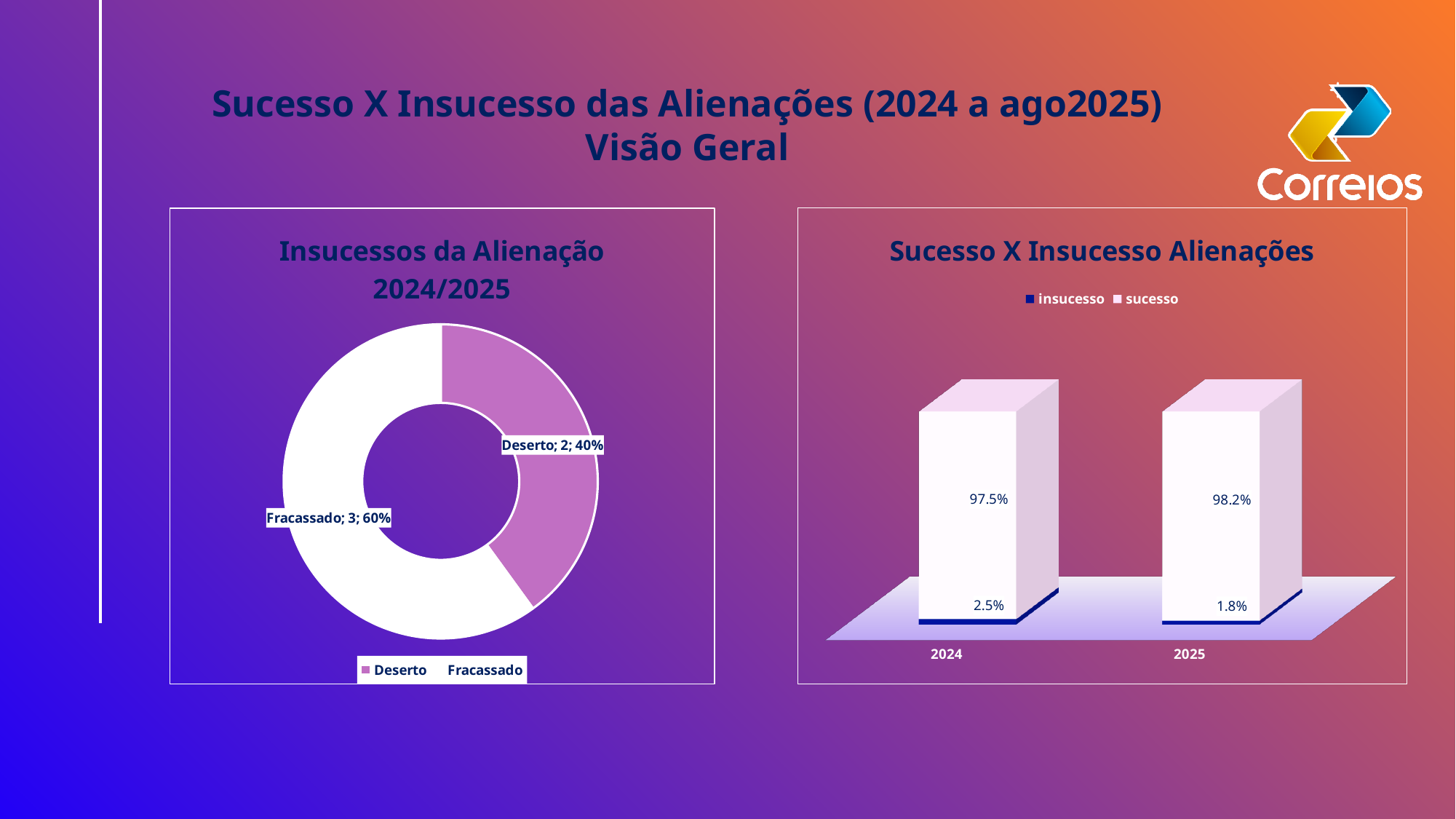
In the 'Sucesso X Insucesso Alienações' chart, does the insucesso value rise or fall from 2024 to 2025? Fall In the 'Sucesso X Insucesso Alienações' chart, what is the insucesso value for 2025? 1.8% In the 'Sucesso X Insucesso Alienações' chart, which year has the higher sucesso value? 2025 In the 'Insucessos da Alienação 2024/2025' chart, what is the difference between the Fracassado and Deserto counts? 1 In the 'Sucesso X Insucesso Alienações' chart, what is the sucesso value for 2024? 97.5% What kind of chart is 'Insucessos da Alienação 2024/2025'? Doughnut chart How many categories does the 'Insucessos da Alienação 2024/2025' chart show? 2 In the 'Insucessos da Alienação 2024/2025' chart, what share of the total does Fracassado represent? 60% In the 'Sucesso X Insucesso Alienações' chart, how many series does the legend list? 2 What kind of chart is 'Sucesso X Insucesso Alienações'? Bar chart In the 'Insucessos da Alienação 2024/2025' chart, which category has the larger value? Fracassado In the 'Insucessos da Alienação 2024/2025' chart, what is the value for Deserto? 2